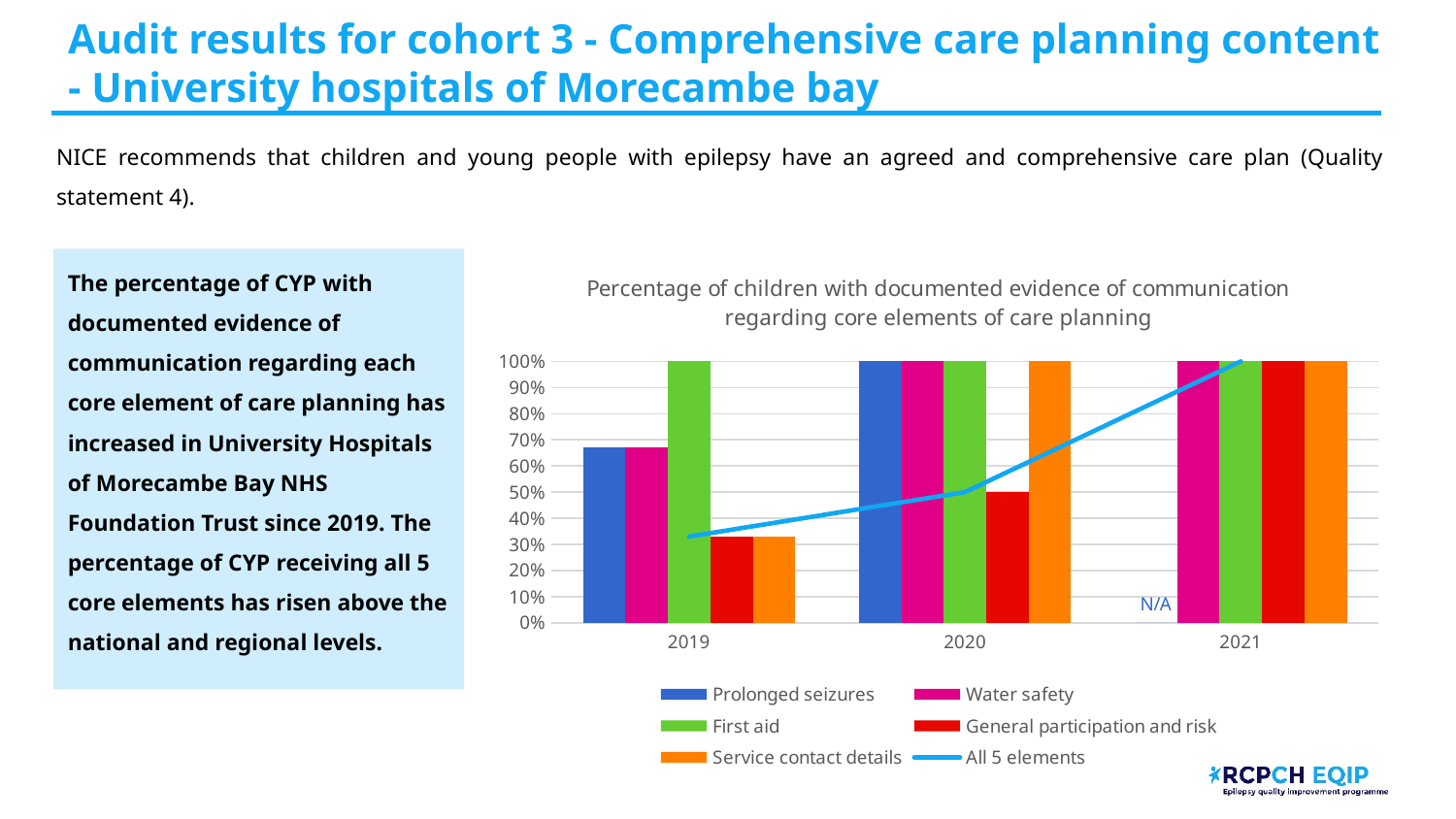
Which series has the lowest value in 2020? General participation and risk and All 5 elements (both 50%) Is the value for General participation and risk in 2019 greater or less than 50%? less Is the value for Prolonged seizures in 2019 greater or less than 50%? greater What is the value for General participation and risk in 2020? 50% In 2019, which is larger: First aid or Service contact details? First aid What kind of chart is shown on the slide? bar and line chart Does the All 5 elements line rise or fall from 2019 to 2021? rise What is shown for Prolonged seizures in 2021? N/A How many years are shown along the x axis of the chart? 3 How many series does the chart legend list? 6 What is the title of the chart? Percentage of children with documented evidence of communication regarding core elements of care planning What is the value for First aid in 2019? 100%